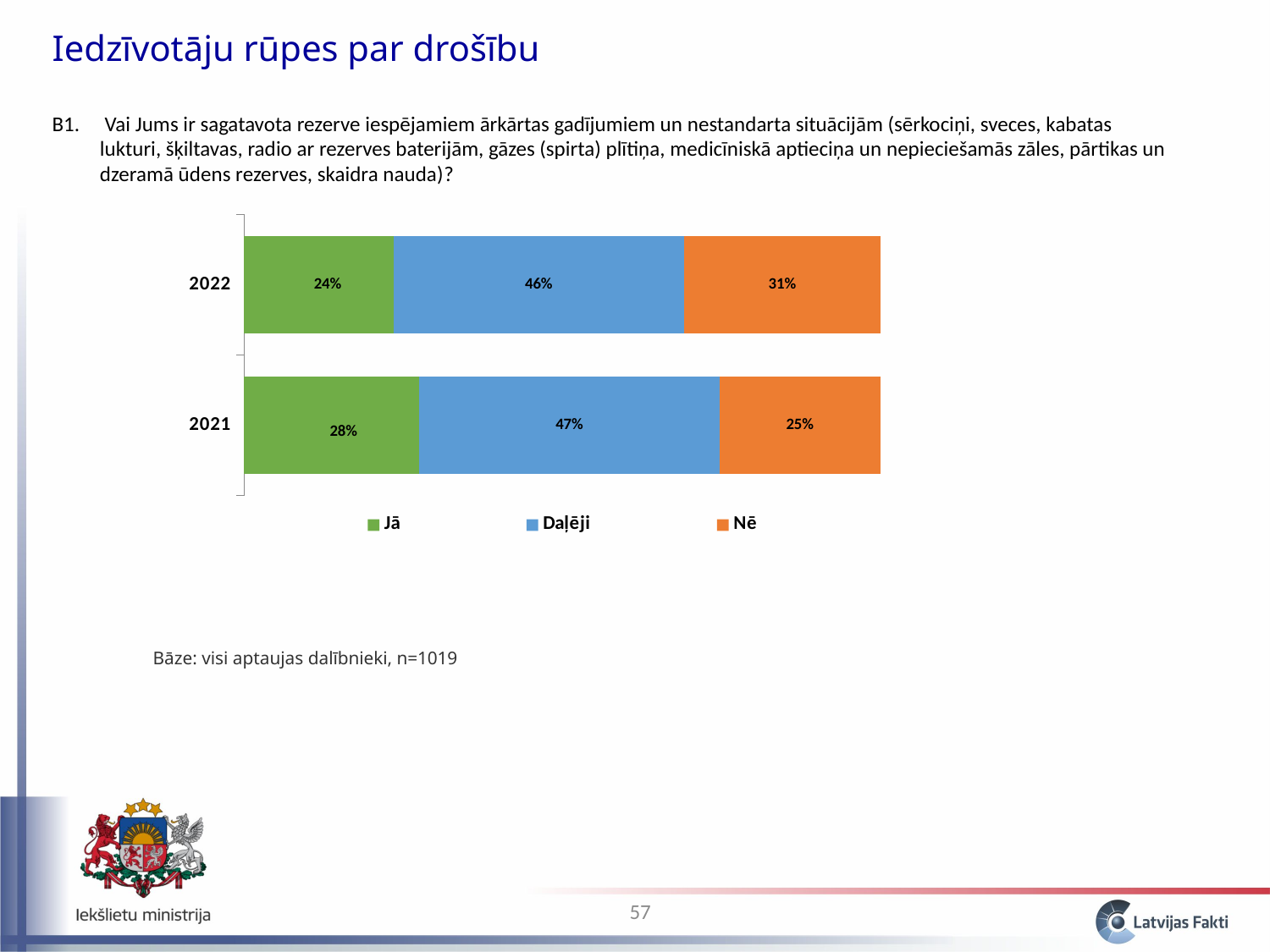
Which response category has the smallest share in 2021? Nē What percentage answered "Jā" in 2021? 28% Which year has the higher share of "Jā" answers? 2021 What is the difference in the "Jā" share between 2021 and 2022? 4 percentage points What is the difference in the "Nē" share between 2022 and 2021? 6 percentage points Which year has the higher share of "Nē" answers? 2022 How many series does the legend list? 3 What percentage answered "Nē" in 2022? 31% Which response category has the largest share in 2022? Daļēji What kind of chart is shown on the slide? Stacked bar chart What percentage answered "Jā" in 2022? 24% What percentage answered "Daļēji" in 2021? 47%